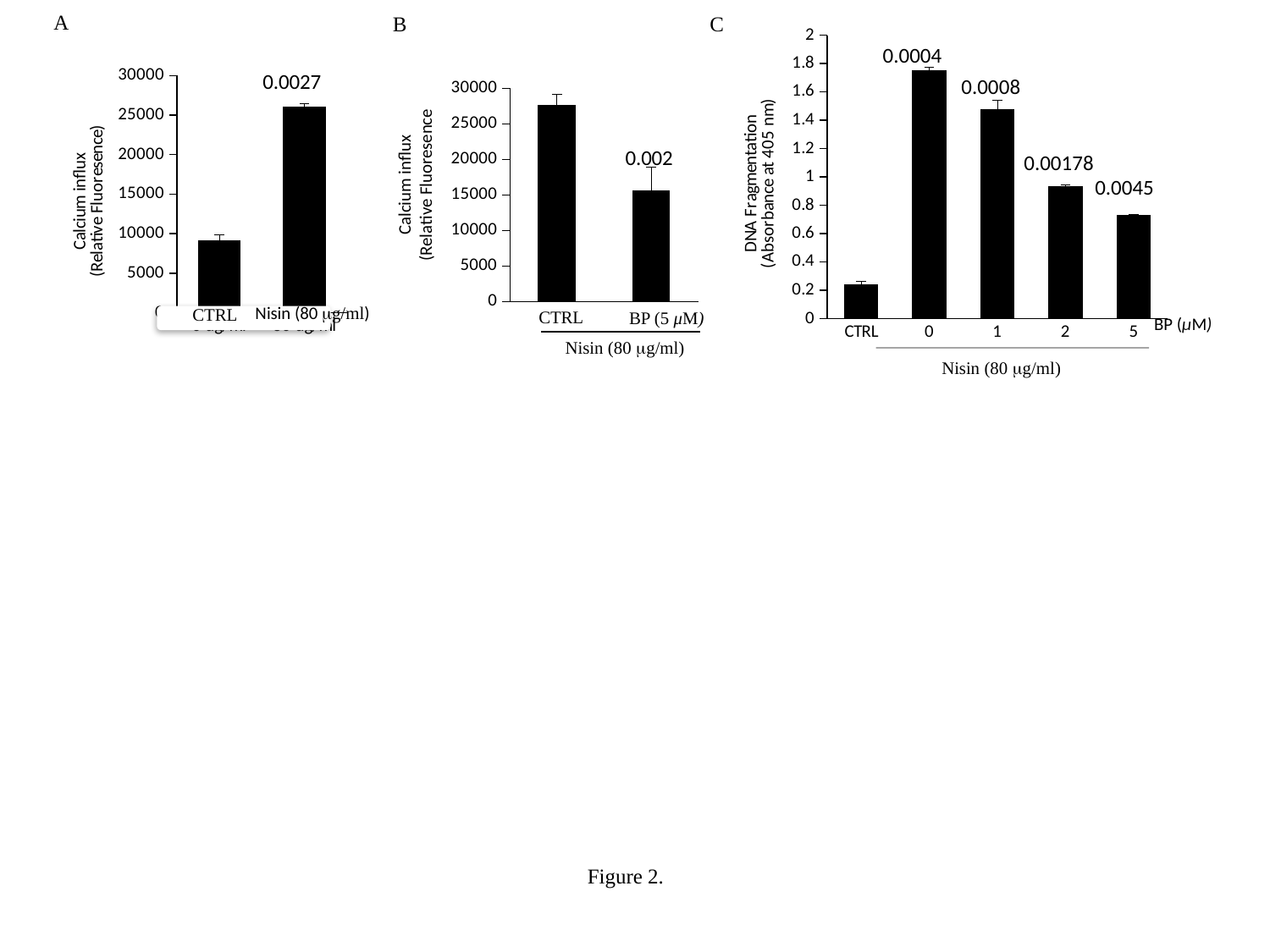
In chart C, which category has the highest DNA fragmentation? 0 What kind of chart is chart A? bar chart In chart A, is the value for CTRL greater or less than 10000? less In chart B, which category has the lower calcium influx? BP (5 μM) In chart B, is the value for BP (5 μM) greater or less than 20000? less In chart C, is the value for BP 2 μM greater or less than 1? less In chart C, which category has the lowest DNA fragmentation? CTRL In chart C, do the values rise or fall as the BP concentration increases from 0 to 5 μM? fall How many bars are plotted in chart C? 5 In chart A, which category has the higher calcium influx? Nisin (80 μg/ml)